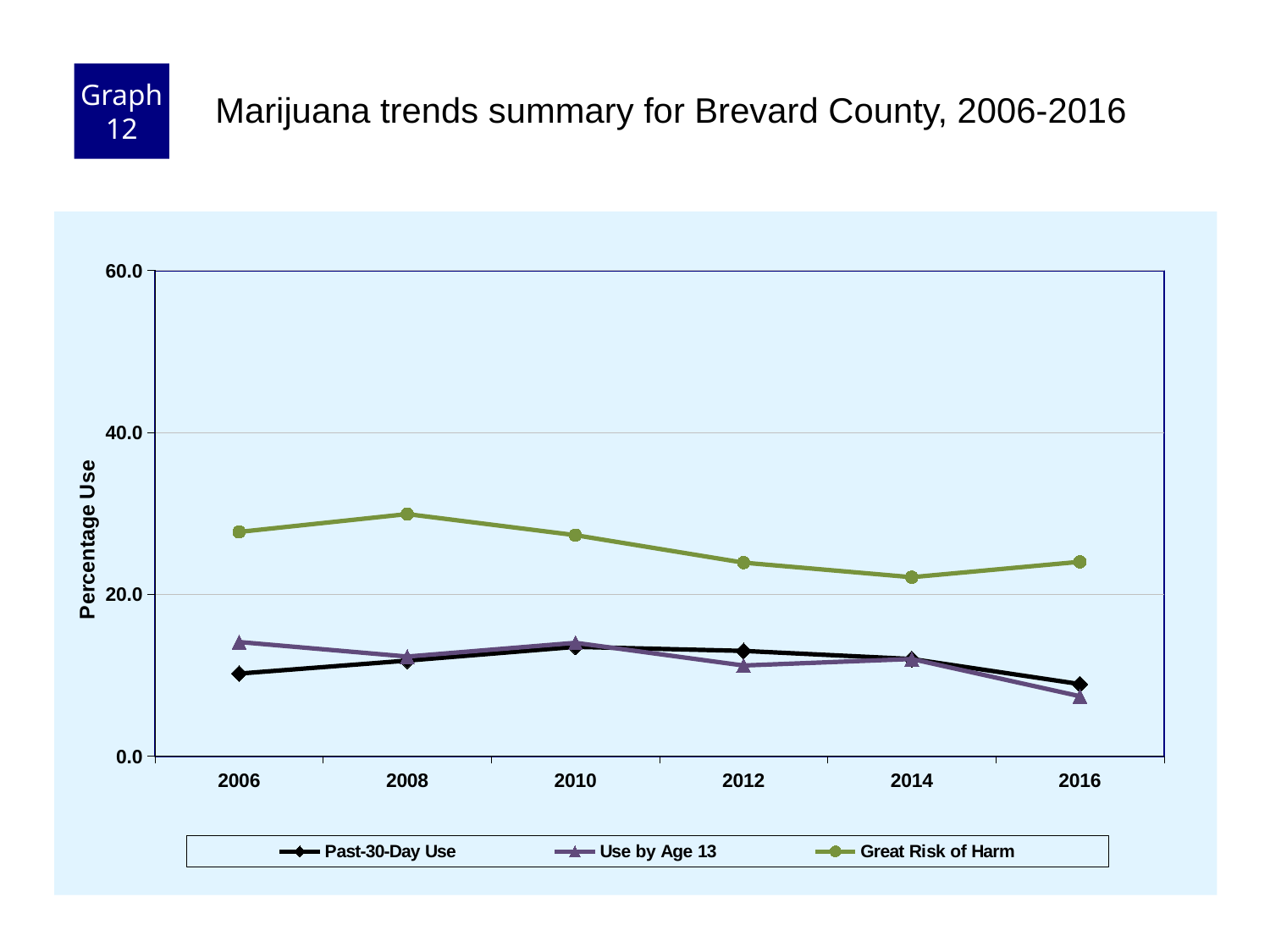
Is the value for Past-30-Day Use in 2006 greater or less than 20.0? less How many series does the legend list? 3 How many years are plotted along the x axis? 6 In which year does the Great Risk of Harm series reach its lowest value? 2014 In which year is the Use by Age 13 series at its lowest? 2016 Is the value for Great Risk of Harm in 2008 greater or less than 20.0? greater Which series is plotted with the highest values across all years? Great Risk of Harm Does the Great Risk of Harm series rise or fall between 2008 and 2014? Fall In which year does the Great Risk of Harm series reach its highest value? 2008 What is the label on the y axis? Percentage Use What kind of chart is shown on the slide? Line chart In 2006, which is higher: Use by Age 13 or Past-30-Day Use? Use by Age 13